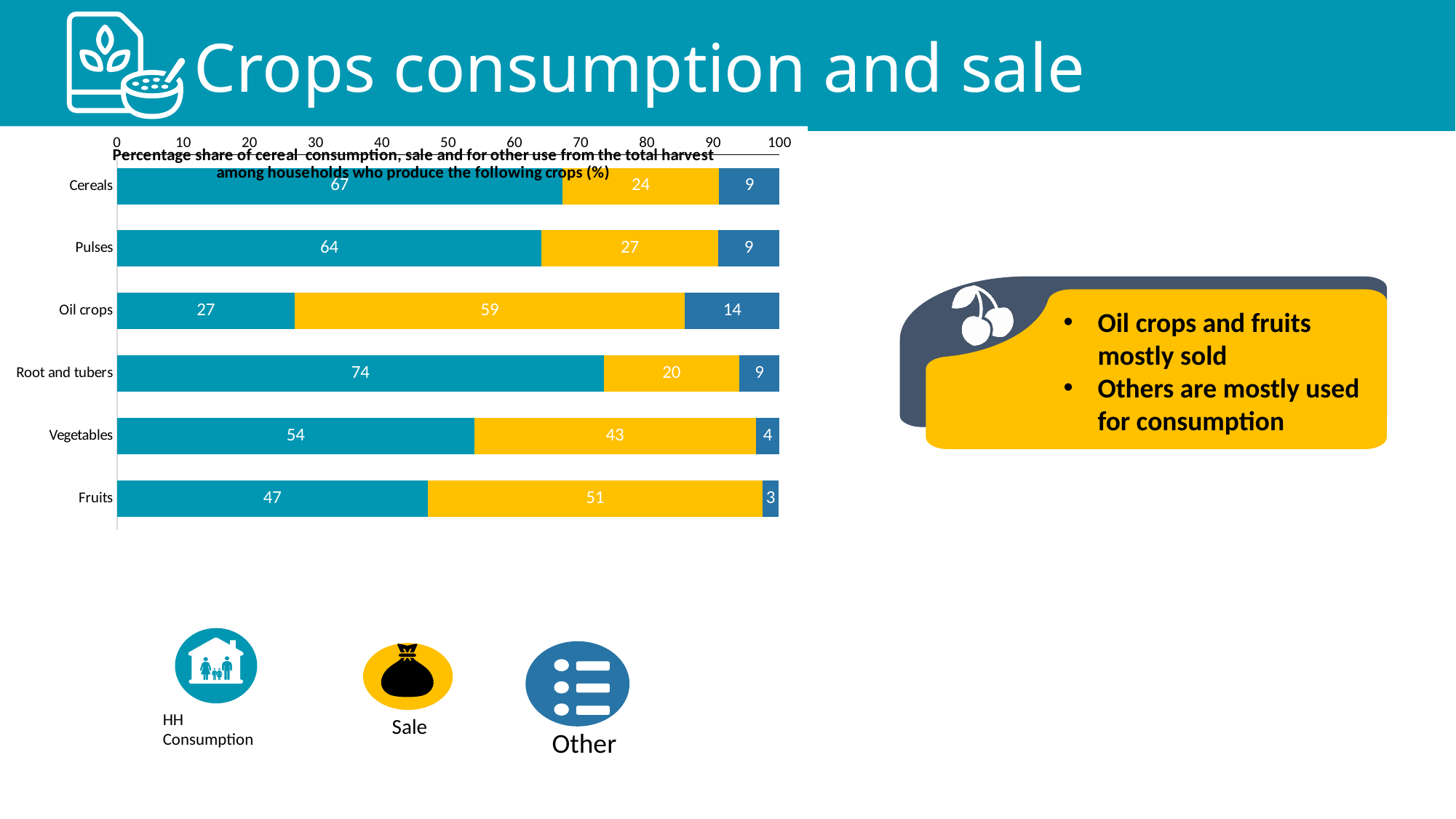
How many crop categories are shown in the chart? 6 What is the total of the stacked bar for Oil crops? 100 What is the difference between the Sale values for Fruits and Cereals? 27 Which crop has the highest HH Consumption value? Root and tubers How many series does the legend list? 3 What is the HH Consumption value for Root and tubers? 74 What is the Sale value for Oil crops? 59 What is the Other value for Vegetables? 4 Which is larger for Fruits, the HH Consumption value or the Sale value? Sale Which crop has the lowest Other value? Fruits What kind of chart is shown on the slide? Stacked bar chart Is the HH Consumption value for Pulses greater or less than 50? greater